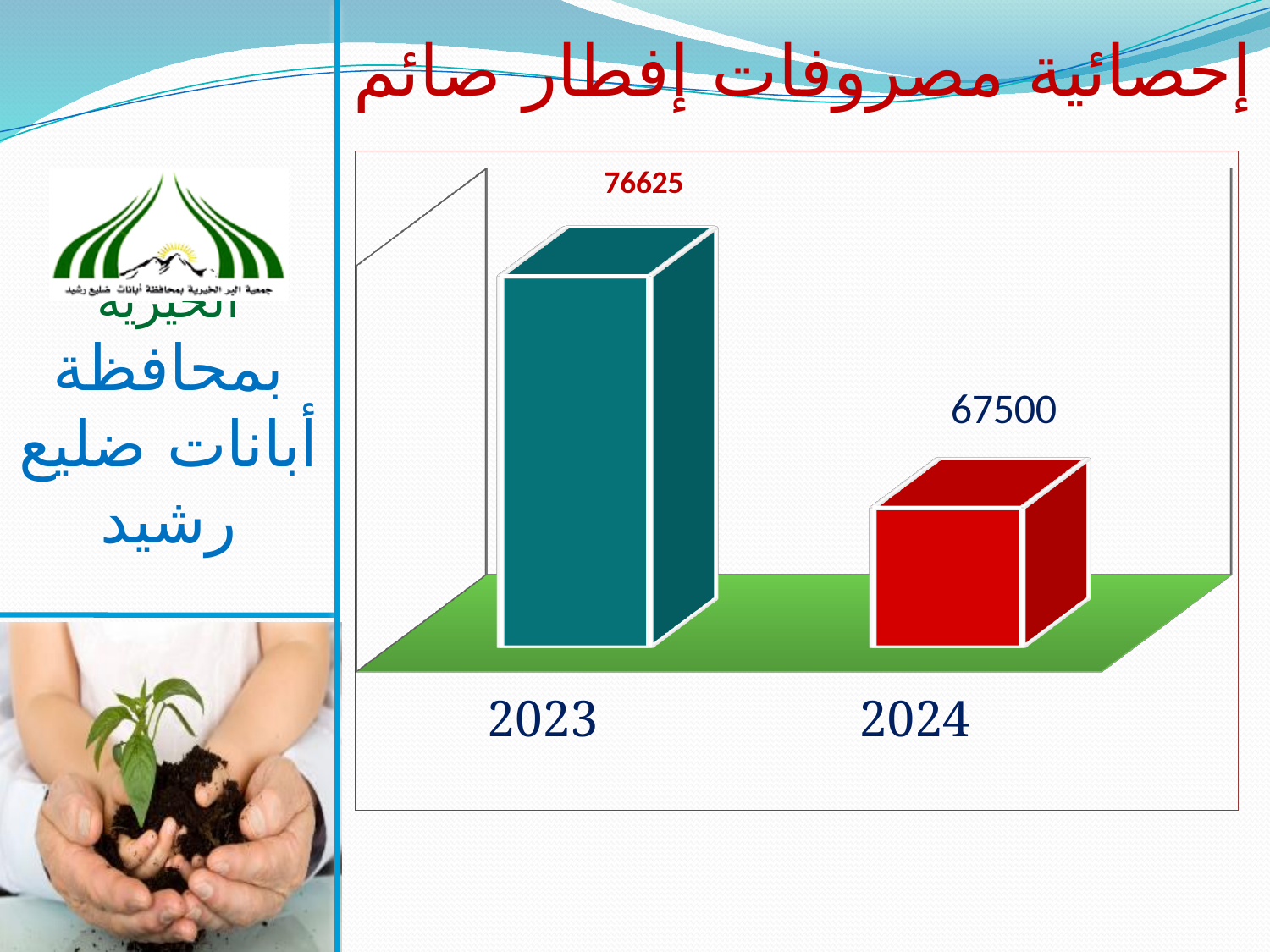
What is the value shown for 2023? 76625 Is the value for 2023 larger or smaller than the value for 2024? larger Do the values rise or fall from 2023 to 2024? fall Which year has the higher value? 2023 How many categories are plotted on the chart? 2 Which year has the lower value? 2024 What colour is the bar for 2024? red What colour is the bar for 2023? teal What is the value shown for 2024? 67500 What kind of chart is shown on the slide? bar chart What is the difference between the 2023 value and the 2024 value? 9125